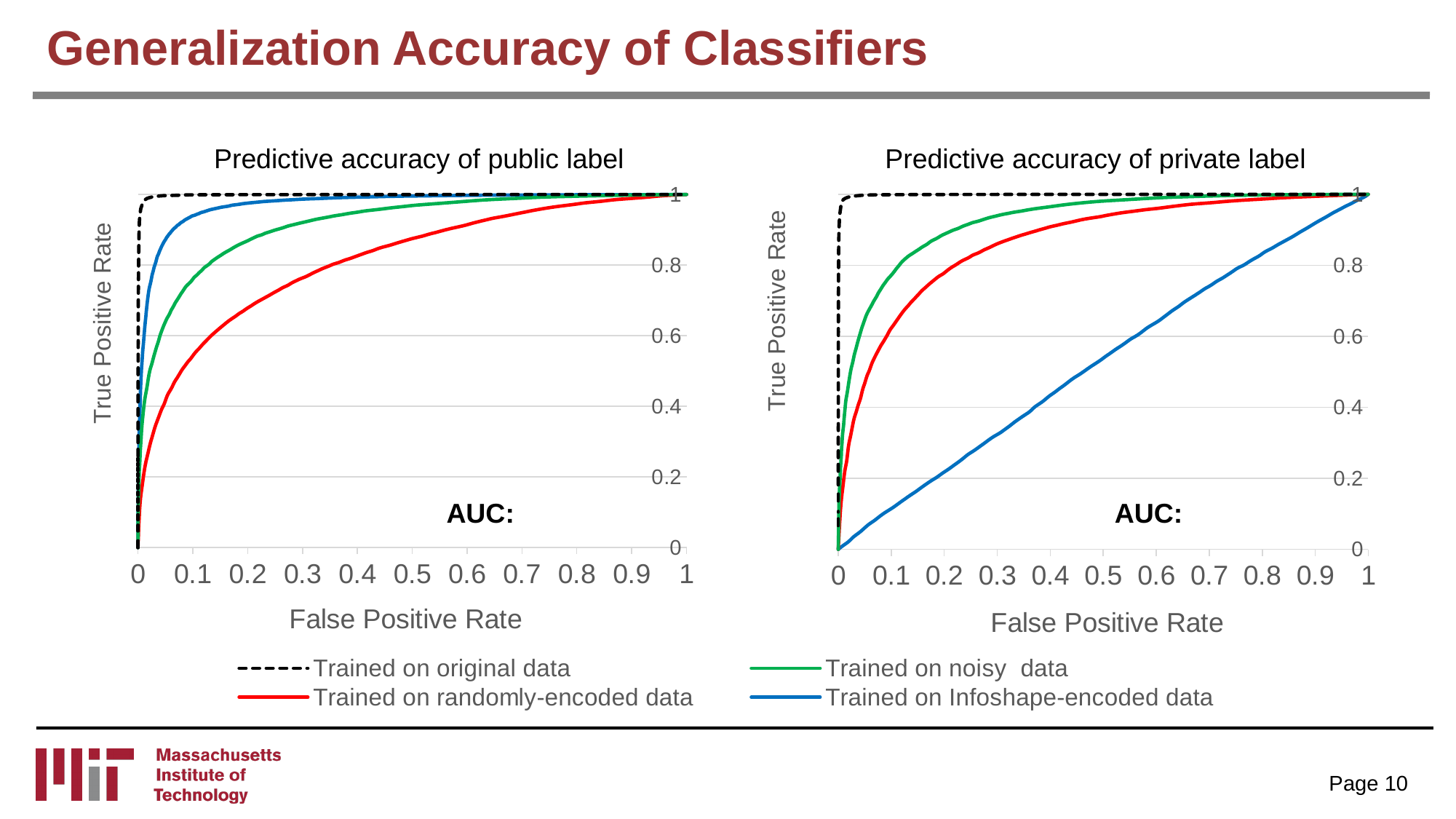
In the 'Predictive accuracy of private label' chart, is the True Positive Rate of the 'Trained on Infoshape-encoded data' series at a False Positive Rate of 0.5 greater or less than 0.8? less What kind of chart is the 'Predictive accuracy of public label' chart? line chart In the 'Predictive accuracy of public label' chart, is the True Positive Rate of the 'Trained on Infoshape-encoded data' series at a False Positive Rate of 0.1 greater or less than 0.8? greater In the 'Predictive accuracy of public label' chart, does the True Positive Rate of the 'Trained on randomly-encoded data' series rise or fall as the False Positive Rate increases? rise How many series does the legend list for the charts? 4 In the 'Predictive accuracy of public label' chart, at a False Positive Rate of 0.1, which series has the higher True Positive Rate: 'Trained on original data' or 'Trained on randomly-encoded data'? Trained on original data In the 'Predictive accuracy of public label' chart, which series has the lowest True Positive Rate at a False Positive Rate of 0.3? Trained on randomly-encoded data What is the title of the chart on the right? Predictive accuracy of private label In the 'Predictive accuracy of private label' chart, at a False Positive Rate of 0.3, which series has the higher True Positive Rate: 'Trained on noisy data' or 'Trained on Infoshape-encoded data'? Trained on noisy data In the 'Predictive accuracy of private label' chart, which series has the lowest True Positive Rate at a False Positive Rate of 0.5? Trained on Infoshape-encoded data In the 'Predictive accuracy of public label' chart, is the True Positive Rate of the 'Trained on randomly-encoded data' series at a False Positive Rate of 0.2 greater or less than 0.8? less What is the x-axis label of the 'Predictive accuracy of public label' chart? False Positive Rate